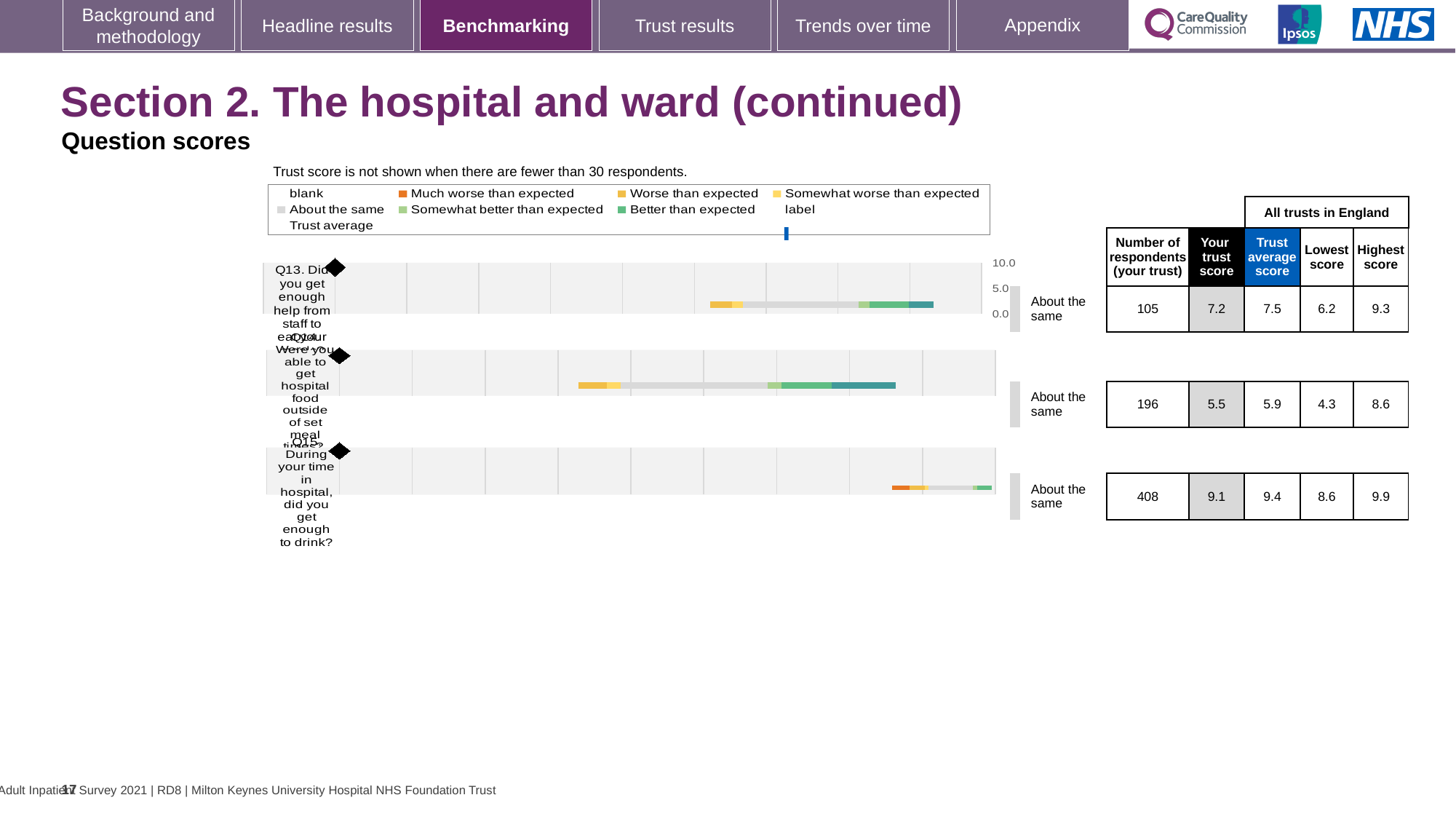
Which of the three questions has the lowest 'Your trust score'? Q14 What kind of chart is used to show the question scores on this slide? bar chart For Q13, what is the difference between the trust average score (7.5) and your trust score (7.2)? 0.3 What is the highest score across all trusts in England for Q13? 9.3 How many questions (Q13, Q14, Q15) are plotted on the slide? 3 What is the trust average score for Q15 (During your time in hospital, did you get enough to drink?)? 9.4 Which of the three questions has the highest 'Your trust score'? Q15 What benchmark category is shown next to each of the three question charts? About the same What is the lowest score across all trusts in England for Q14? 4.3 What is the trust's score for Q14 (Were you able to get hospital food outside of set meal times?)? 5.5 What is the number of respondents for Q13 (Did you get enough help from staff to eat your meals?)? 105 For Q14, which is larger: your trust score or the trust average score? Trust average score